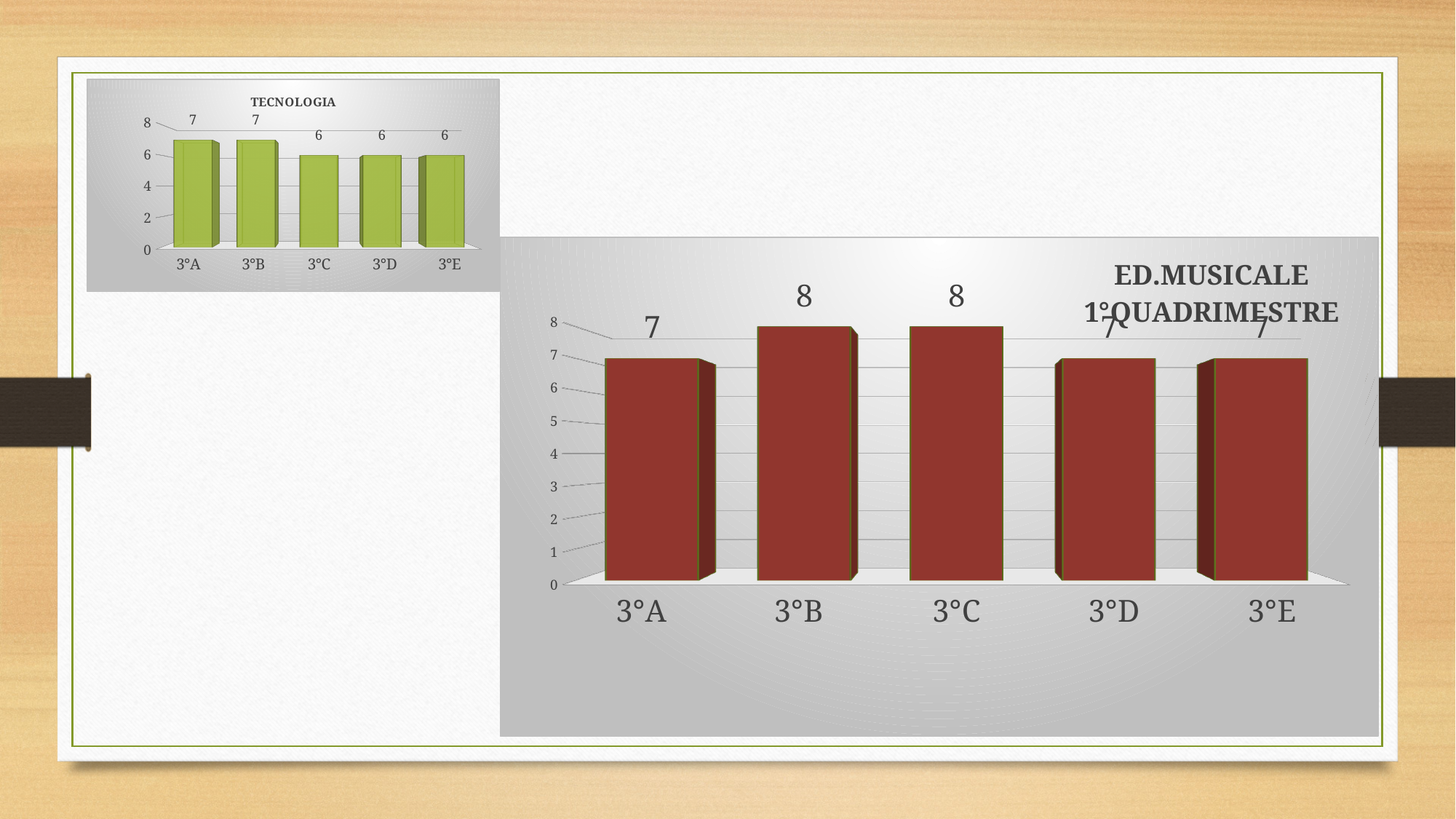
In the ED.MUSICALE 1°QUADRIMESTRE chart, how many bars are plotted? 5 What colour are the bars in the TECNOLOGIA chart? green In the TECNOLOGIA chart, what is the difference between the values for 3°B and 3°E? 1 In the TECNOLOGIA chart, what is the value for 3°C? 6 In the ED.MUSICALE 1°QUADRIMESTRE chart, what is the value for 3°B? 8 In the ED.MUSICALE 1°QUADRIMESTRE chart, what is the difference between the values for 3°C and 3°A? 1 In the TECNOLOGIA chart, what is the value for 3°A? 7 In the ED.MUSICALE 1°QUADRIMESTRE chart, what is the value for 3°E? 7 What kind of chart is the ED.MUSICALE 1°QUADRIMESTRE chart? bar chart In the TECNOLOGIA chart, how many categories are shown on the x axis? 5 In the ED.MUSICALE 1°QUADRIMESTRE chart, which is larger, the value for 3°B or the value for 3°D? 3°B In the TECNOLOGIA chart, which is larger, the value for 3°A or the value for 3°D? 3°A